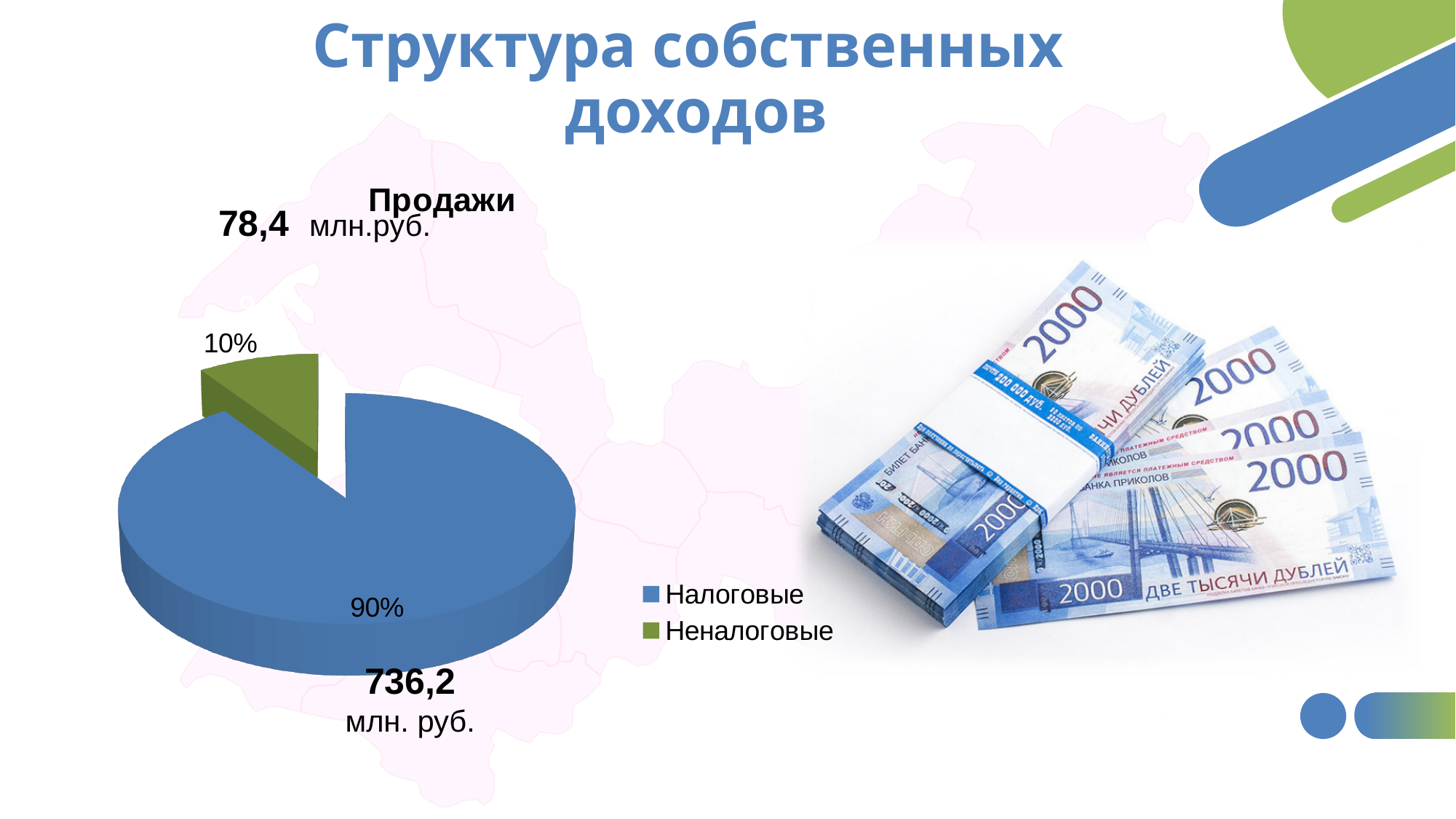
Which category has the largest slice of the pie? Налоговые What is the title of the chart? Продажи Which category has the smallest slice of the pie? Неналоговые How many slices does the pie chart have? 2 What share of the pie does Неналоговые take? 10% What is the value shown for Неналоговые in млн. руб.? 78,4 Which is larger, Налоговые or Неналоговые? Налоговые How many entries does the legend list? 2 What share of the pie does Налоговые take? 90% What kind of chart is shown on the slide? pie chart What colour is the Неналоговые slice? green What is the value shown for Налоговые in млн. руб.? 736,2